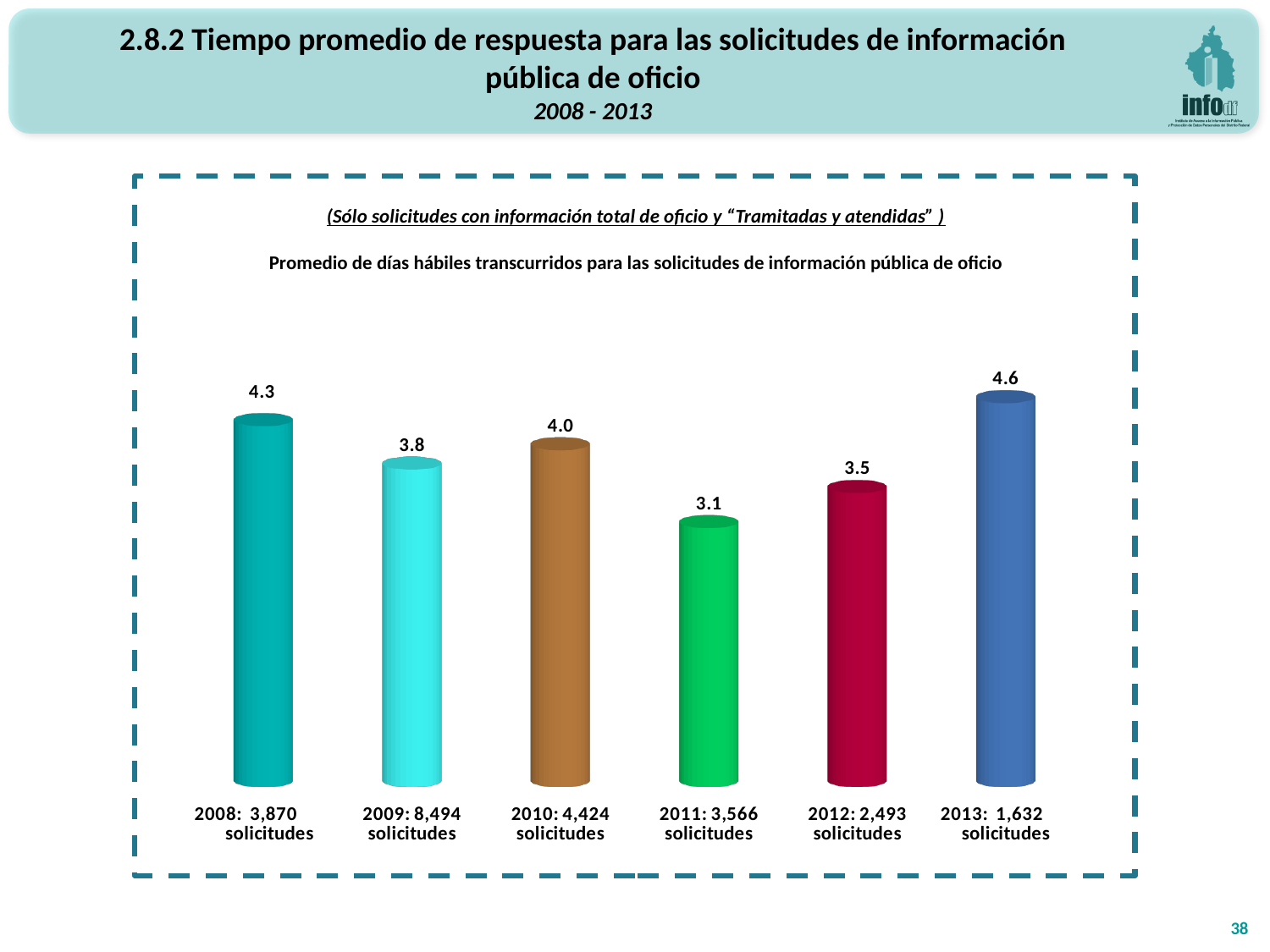
What is the difference between the values for 2013 and 2011? 1.5 How many solicitudes are indicated in the axis label for 2009? 8,494 Which is larger, the value for 2010 or the value for 2012? 2010 Does the value rise or fall from 2012 to 2013? rise What is the value shown for 2013? 4.6 Which year has the lowest average response time? 2011 What is the average number of business days for 2008? 4.3 What is the value shown for 2011? 3.1 What kind of chart is shown on the slide? bar chart Which year has the highest average response time? 2013 What is the difference between the values for 2008 and 2009? 0.5 How many years are shown in the chart? 6